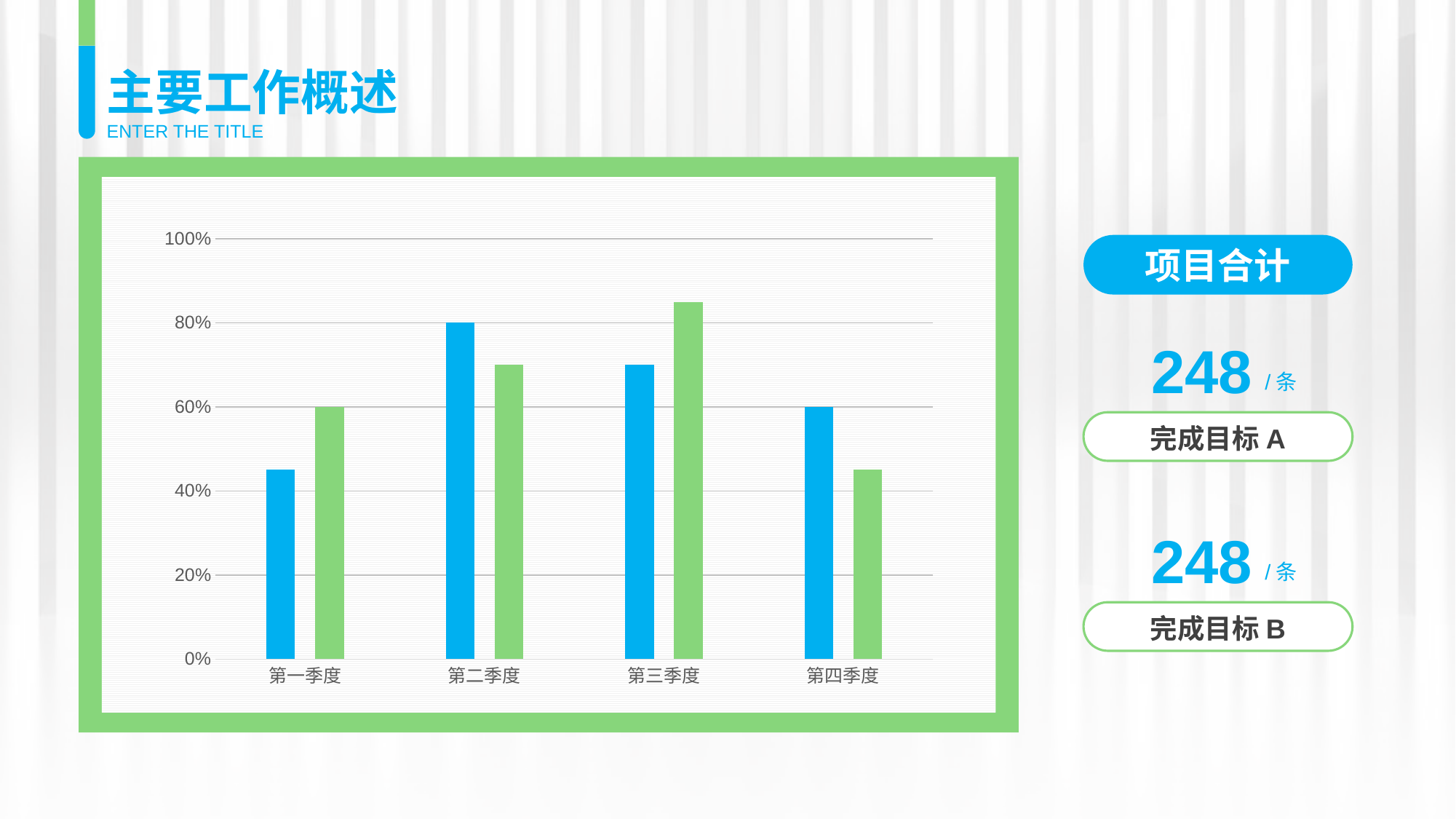
Is the value of the green bar for 第三季度 greater or less than 80%? greater Which quarter has the highest blue bar? 第二季度 How many quarter categories are shown on the x axis of the chart? 4 What is the difference between the blue bar for 第二季度 and the blue bar for 第四季度? 20% Which quarter has the lowest green bar? 第四季度 For 第四季度, is the blue bar or the green bar taller? blue What kind of chart is shown on the slide? bar chart Is the value of the blue bar for 第一季度 greater or less than 60%? less What is the value of the blue bar for 第四季度? 60% For 第三季度, is the blue bar or the green bar taller? green What is the value of the green bar for 第一季度? 60% What is the value of the blue bar for 第二季度? 80%